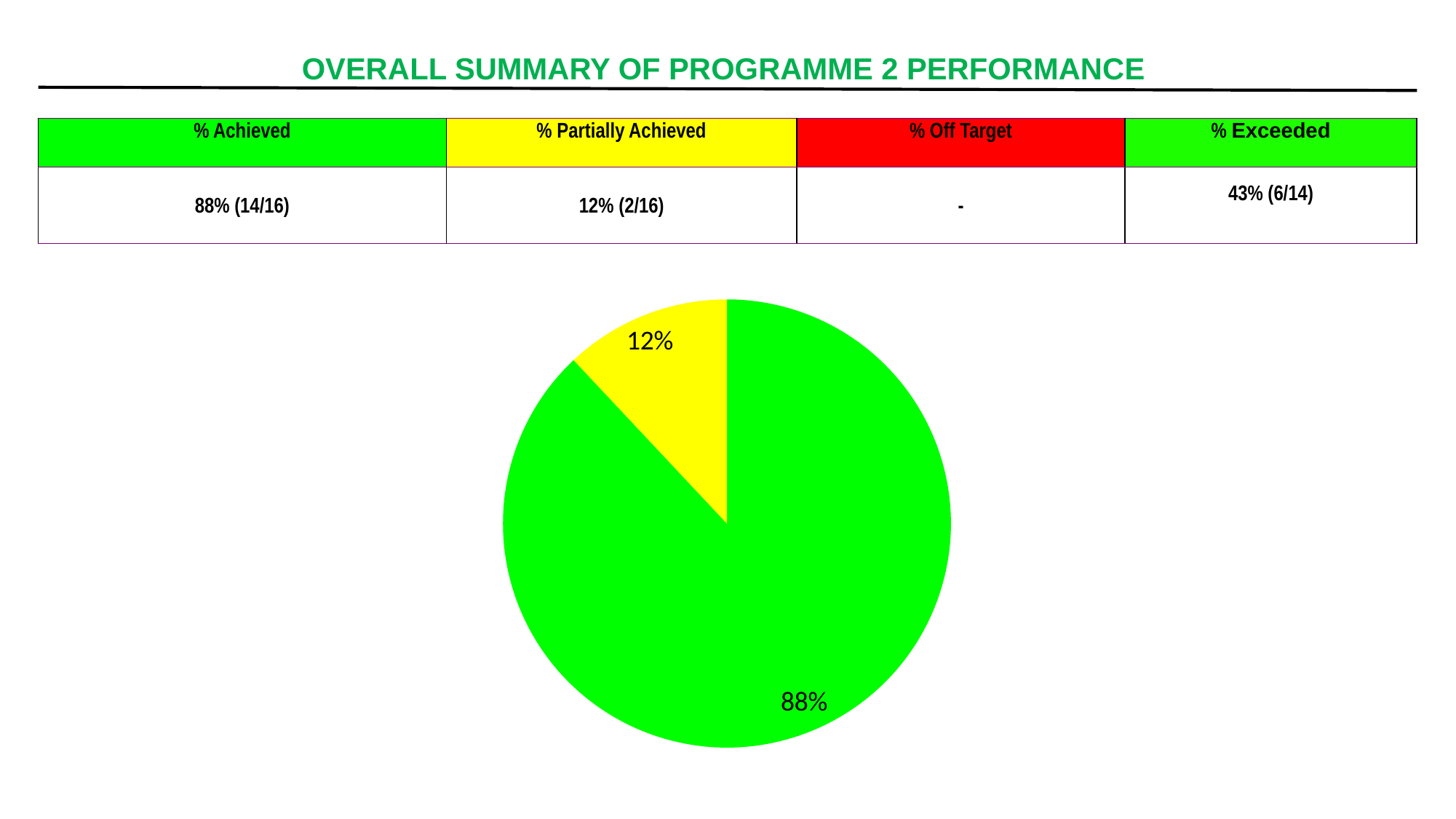
Which colour in the pie chart corresponds to the '% Achieved' category in the table above it? green What kind of chart is shown on the slide? pie chart Is the green slice or the yellow slice of the pie chart larger? the green slice What is the title of the slide containing the pie chart? OVERALL SUMMARY OF PROGRAMME 2 PERFORMANCE Is the value of the green slice of the pie chart greater or less than 50%? greater How many slices does the pie chart have? 2 What share of the pie does the yellow slice represent? 12% Which slice of the pie chart is the largest? the green slice (88%) What is the difference in percentage points between the green slice and the yellow slice of the pie chart? 76 Which slice of the pie chart is the smallest? the yellow slice (12%) What percentage is shown on the green slice of the pie chart? 88% What percentage is shown on the yellow slice of the pie chart? 12%